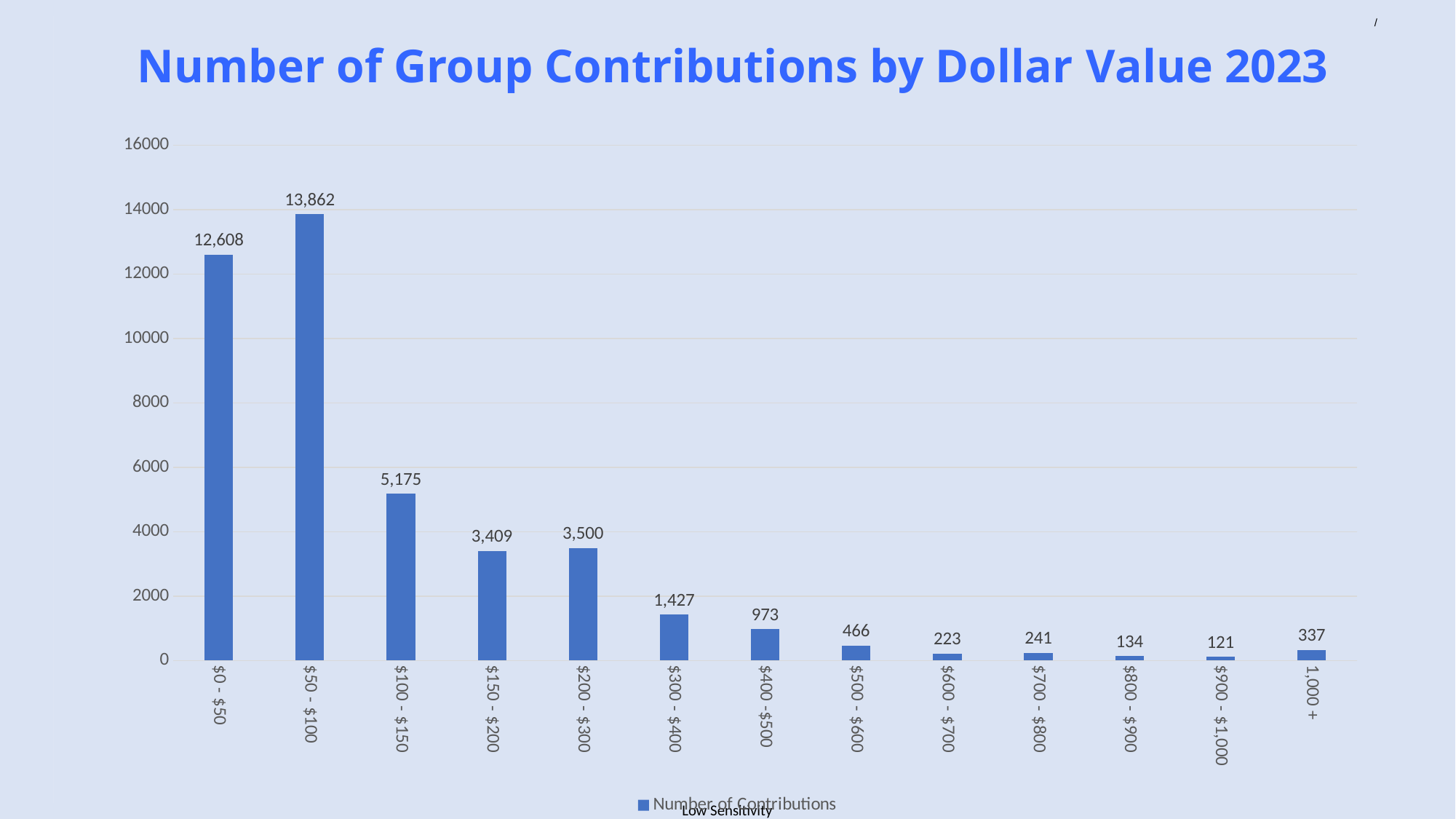
Which dollar value category has the lowest number of contributions? $900 - $1,000 What is the difference in number of contributions between the $50 - $100 and $0 - $50 categories? 1,254 Is the value for $100 - $150 greater or less than 6000? less Which dollar value category has the highest number of contributions? $50 - $100 What is the title of the chart? Number of Group Contributions by Dollar Value 2023 What is the number of contributions for the $50 - $100 category? 13,862 How many dollar value categories are shown on the chart? 13 What kind of chart is shown on the slide? bar chart How many series does the legend list? 1 Which has more contributions, the $150 - $200 category or the $200 - $300 category? $200 - $300 What is the number of contributions for the $400 - $500 category? 973 What is the number of contributions for the 1,000 + category? 337